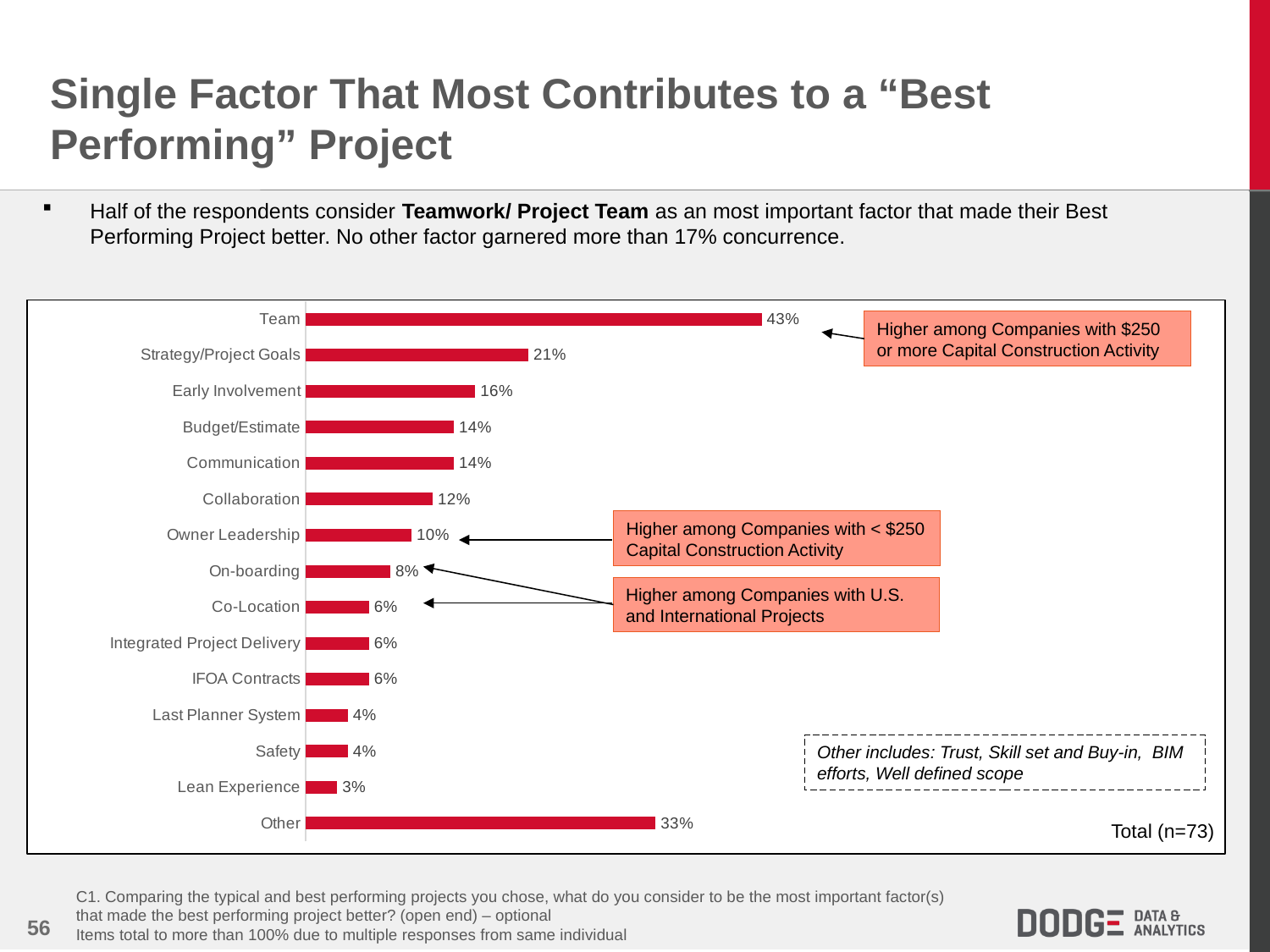
What is the value for Strategy/Project Goals? 21% What is the value for Other? 33% What is the difference between the values for Other and Lean Experience? 30% What is the difference between the values for Team and Strategy/Project Goals? 22% What is the value for Team? 43% Which category has the lowest value? Lean Experience How many categories are shown in the chart? 15 Which is larger, the value for Early Involvement or the value for Collaboration? Early Involvement What kind of chart is shown on the slide? Bar chart What is the value for Owner Leadership? 10% Which category has the highest value? Team What is the total sample size shown on the chart? n=73